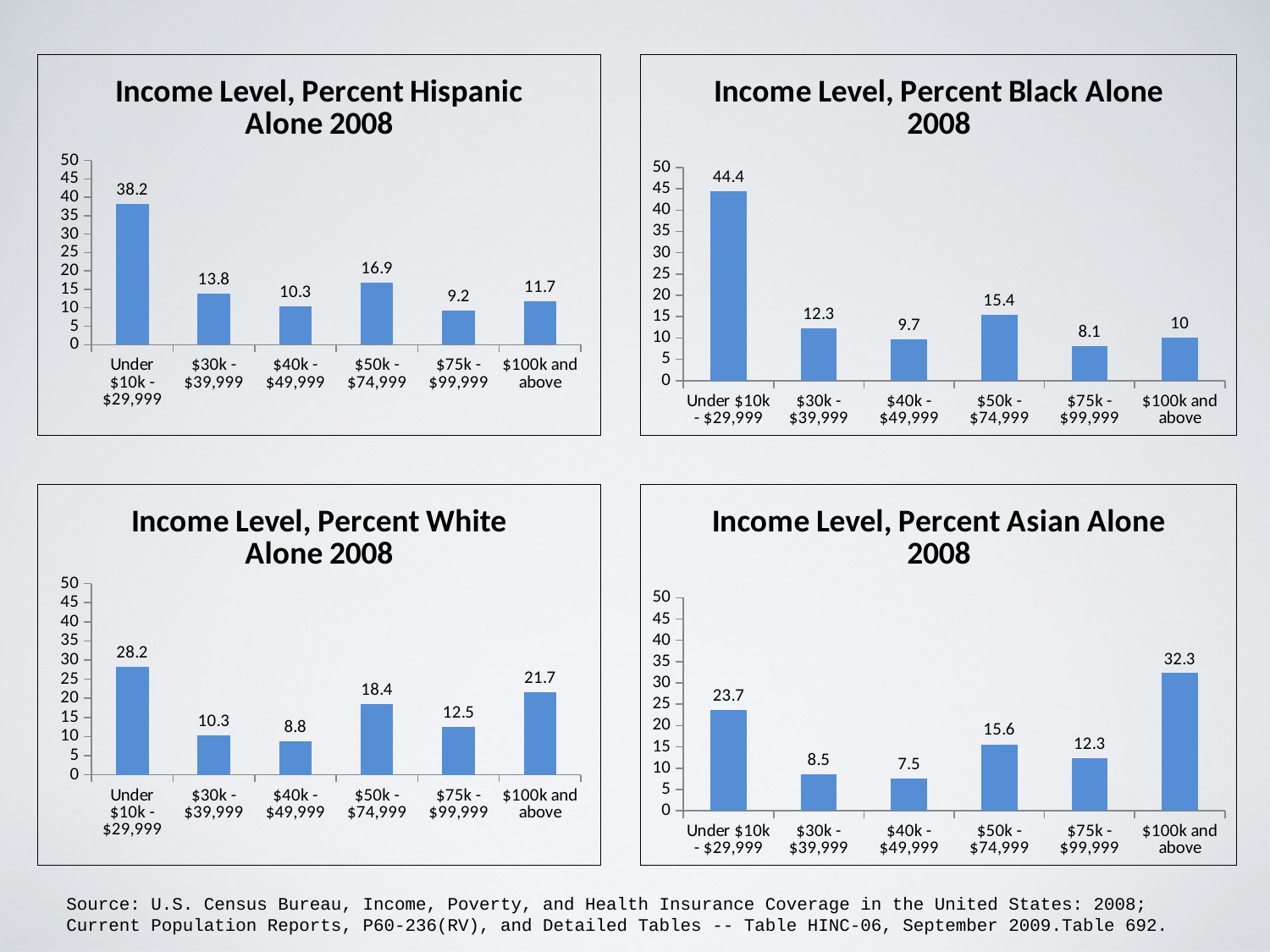
What kind of chart is the 'Income Level, Percent Black Alone 2008' chart? bar chart In the 'Income Level, Percent Asian Alone 2008' chart, what is the difference between the $50k - $74,999 value and the $40k - $49,999 value? 8.1 In the 'Income Level, Percent Hispanic Alone 2008' chart, is the value for $50k - $74,999 greater or less than 20? less In the 'Income Level, Percent Asian Alone 2008' chart, which is larger: the value for Under $10k - $29,999 or the value for $100k and above? $100k and above In the 'Income Level, Percent Hispanic Alone 2008' chart, what is the value for the Under $10k - $29,999 category? 38.2 How many charts are shown on the slide? 4 How many income categories are shown in the 'Income Level, Percent White Alone 2008' chart? 6 In the 'Income Level, Percent White Alone 2008' chart, which income category has the lowest value? $40k - $49,999 In the 'Income Level, Percent Black Alone 2008' chart, what is the difference between the Under $10k - $29,999 value and the $30k - $39,999 value? 32.1 In the 'Income Level, Percent White Alone 2008' chart, what is the value for the $75k - $99,999 category? 12.5 In the 'Income Level, Percent Black Alone 2008' chart, what is the value for the $100k and above category? 10 In the 'Income Level, Percent Asian Alone 2008' chart, which income category has the highest value? $100k and above